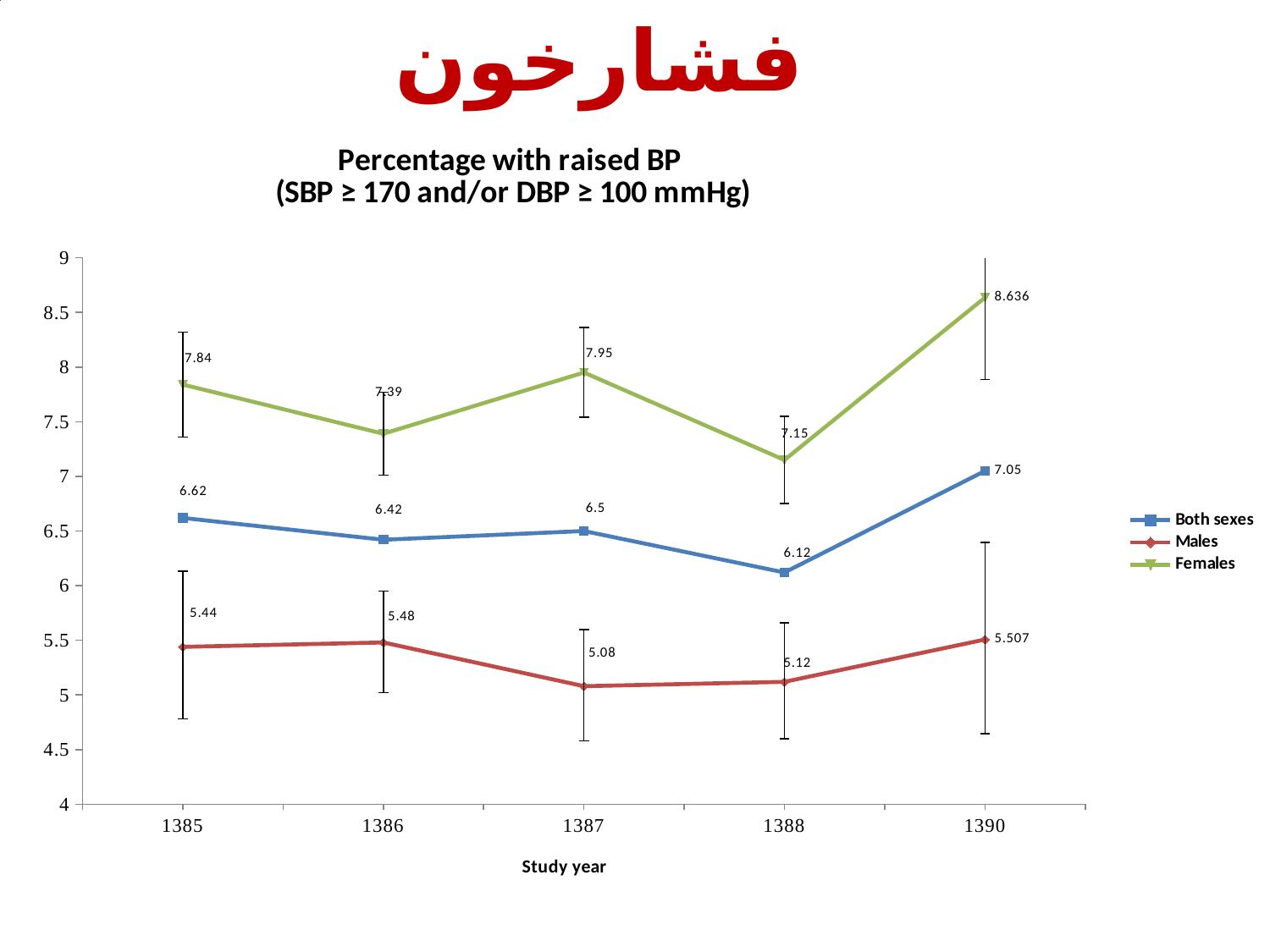
What kind of chart is shown on the slide? line chart How many study years are plotted on the x axis? 5 What is the value for Females in study year 1390? 8.636 Which is larger: the Both sexes value in 1390 or the Both sexes value in 1385? 1390 How many series does the legend list? 3 Is the Males value in study year 1386 greater or less than 6? less What is the difference between the Females and Males values in study year 1385? 2.4 In which study year is the Both sexes value lowest? 1388 What is the value for Males in study year 1387? 5.08 What is the value for Both sexes in study year 1388? 6.12 In which study year is the Females value highest? 1390 What is the label of the x axis? Study year